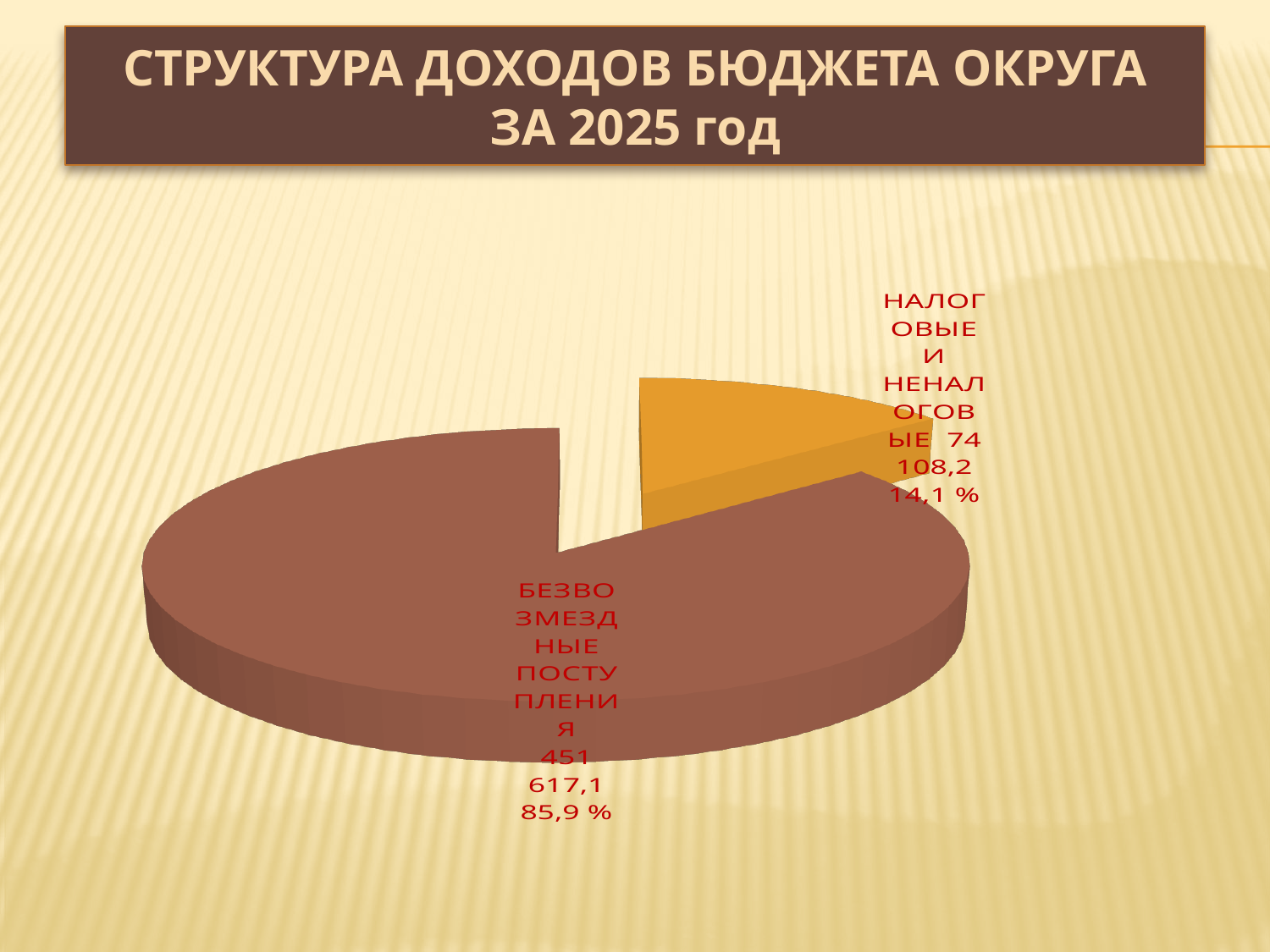
What value is shown for the БЕЗВОЗМЕЗДНЫЕ ПОСТУПЛЕНИЯ slice of the pie chart? 451 617,1 What type of chart is shown on the slide? Pie chart What share of the pie does the БЕЗВОЗМЕЗДНЫЕ ПОСТУПЛЕНИЯ slice represent? 85,9 % Which is larger: БЕЗВОЗМЕЗДНЫЕ ПОСТУПЛЕНИЯ or НАЛОГОВЫЕ И НЕНАЛОГОВЫЕ? БЕЗВОЗМЕЗДНЫЕ ПОСТУПЛЕНИЯ What is the title of the slide? СТРУКТУРА ДОХОДОВ БЮДЖЕТА ОКРУГА ЗА 2025 год By how many percentage points does the share of БЕЗВОЗМЕЗДНЫЕ ПОСТУПЛЕНИЯ exceed that of НАЛОГОВЫЕ И НЕНАЛОГОВЫЕ? 71,8 How many slices does the pie chart have? 2 Which category has the largest slice in the pie chart? БЕЗВОЗМЕЗДНЫЕ ПОСТУПЛЕНИЯ Which category has the smallest slice in the pie chart? НАЛОГОВЫЕ И НЕНАЛОГОВЫЕ What share of the pie does the НАЛОГОВЫЕ И НЕНАЛОГОВЫЕ slice represent? 14,1 % What is the difference between the values of БЕЗВОЗМЕЗДНЫЕ ПОСТУПЛЕНИЯ and НАЛОГОВЫЕ И НЕНАЛОГОВЫЕ? 377 508,9 What value is shown for the НАЛОГОВЫЕ И НЕНАЛОГОВЫЕ slice of the pie chart? 74 108,2